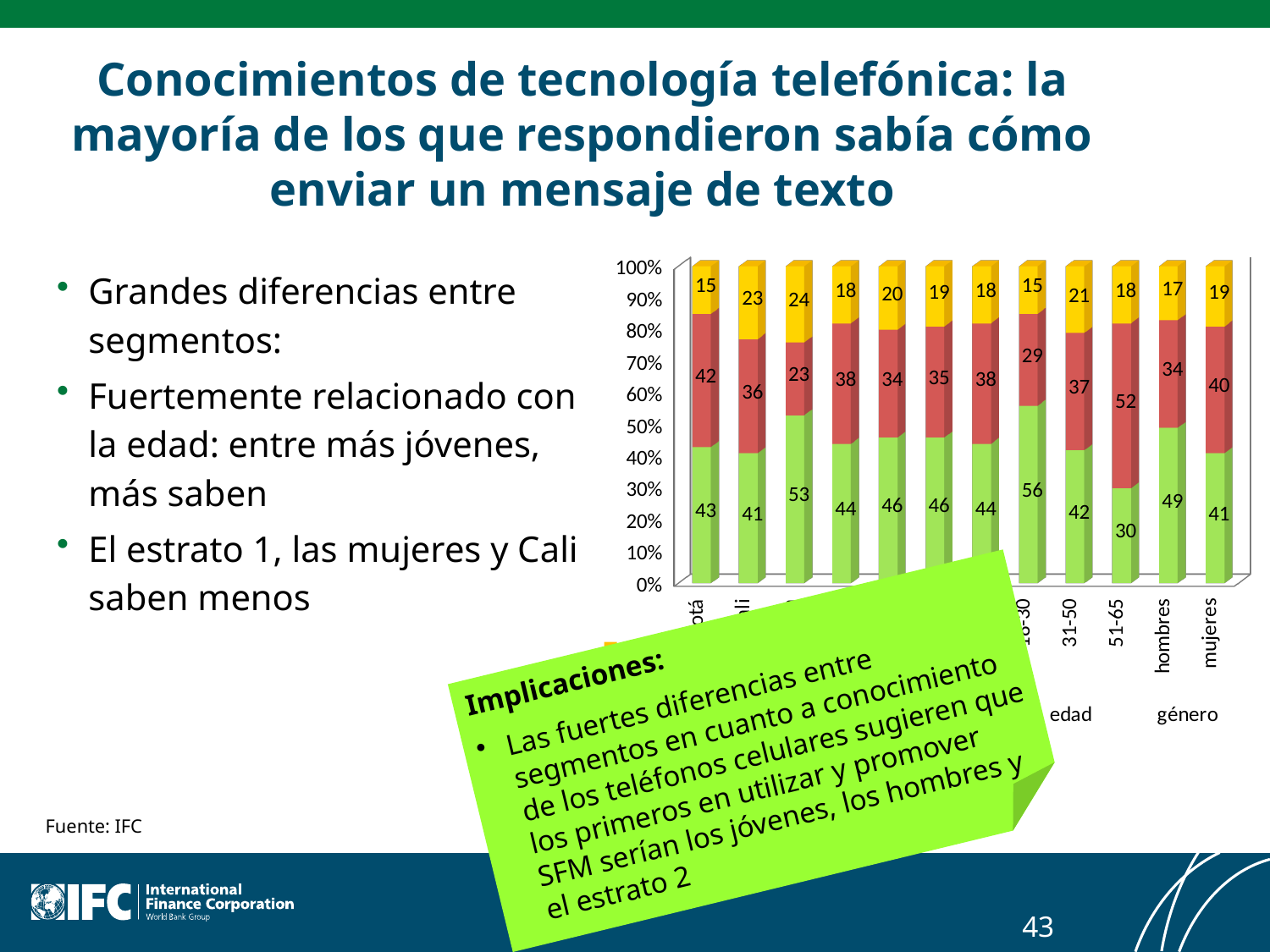
Which bar has the smallest green (bottom) segment? 51-65 What is the value of the red (middle) segment for the 51-65 bar? 52 How many bars are plotted in the chart? 12 Which bar has the largest red (middle) segment? 51-65 What type of chart is shown on the slide? Stacked bar chart What is the value of the green (bottom) segment for the 31-50 bar? 42 What is the value of the green (bottom) segment for the 51-65 bar? 30 Which bar has the larger green (bottom) segment, hombres or mujeres? hombres What is the value of the yellow (top) segment for the hombres bar? 17 What is the difference between the green (bottom) segment values of hombres and mujeres? 8 What is the value of the red (middle) segment for the mujeres bar? 40 What is the total of the three segments in the 51-65 bar? 100